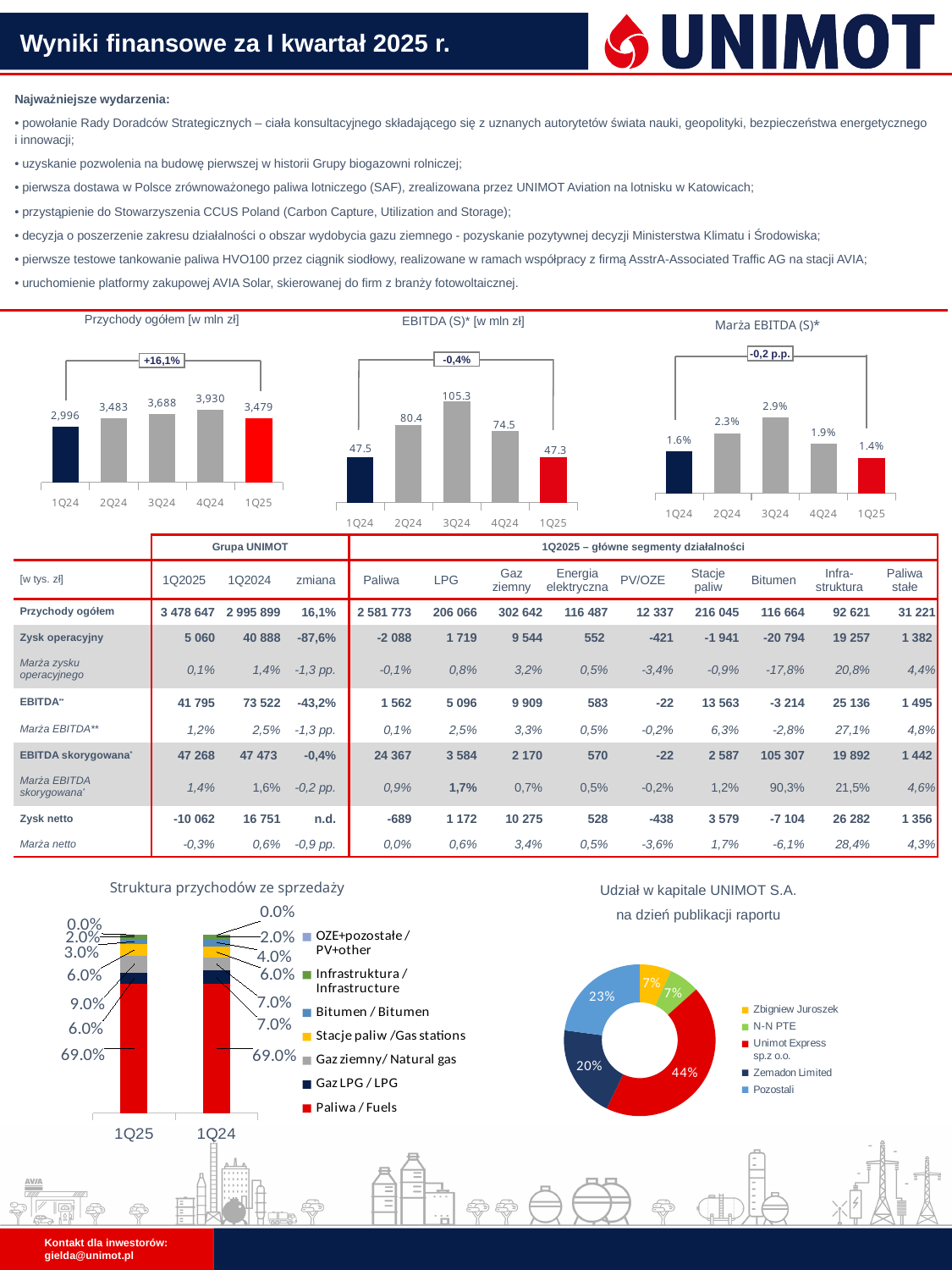
In the 'Marża EBITDA (S)*' chart, is the value for 2Q24 larger or smaller than the value for 4Q24? larger In the 'Udział w kapitale UNIMOT S.A.' chart, what share does Unimot Express sp.z o.o. hold? 44% In the 'Struktura przychodów ze sprzedaży' chart, what is the share of Gaz ziemny / Natural gas in 1Q25? 9.0% In the 'Przychody ogółem [w mln zł]' chart, which quarter has the lowest value? 1Q24 In the 'Przychody ogółem [w mln zł]' chart, what is the value for 4Q24? 3,930 In the 'EBITDA (S)* [w mln zł]' chart, which quarter has the highest value? 3Q24 In the 'Udział w kapitale UNIMOT S.A.' chart, how many entries does the legend list? 5 In the 'Przychody ogółem [w mln zł]' chart, what is the difference between 4Q24 and 1Q24? 934 In the 'Marża EBITDA (S)*' chart, what is the value for 1Q25? 1.4% In the 'Marża EBITDA (S)*' chart, which quarter has the lowest value? 1Q25 In the 'EBITDA (S)* [w mln zł]' chart, what is the value for 2Q24? 80.4 In the 'EBITDA (S)* [w mln zł]' chart, how many quarters are shown? 5